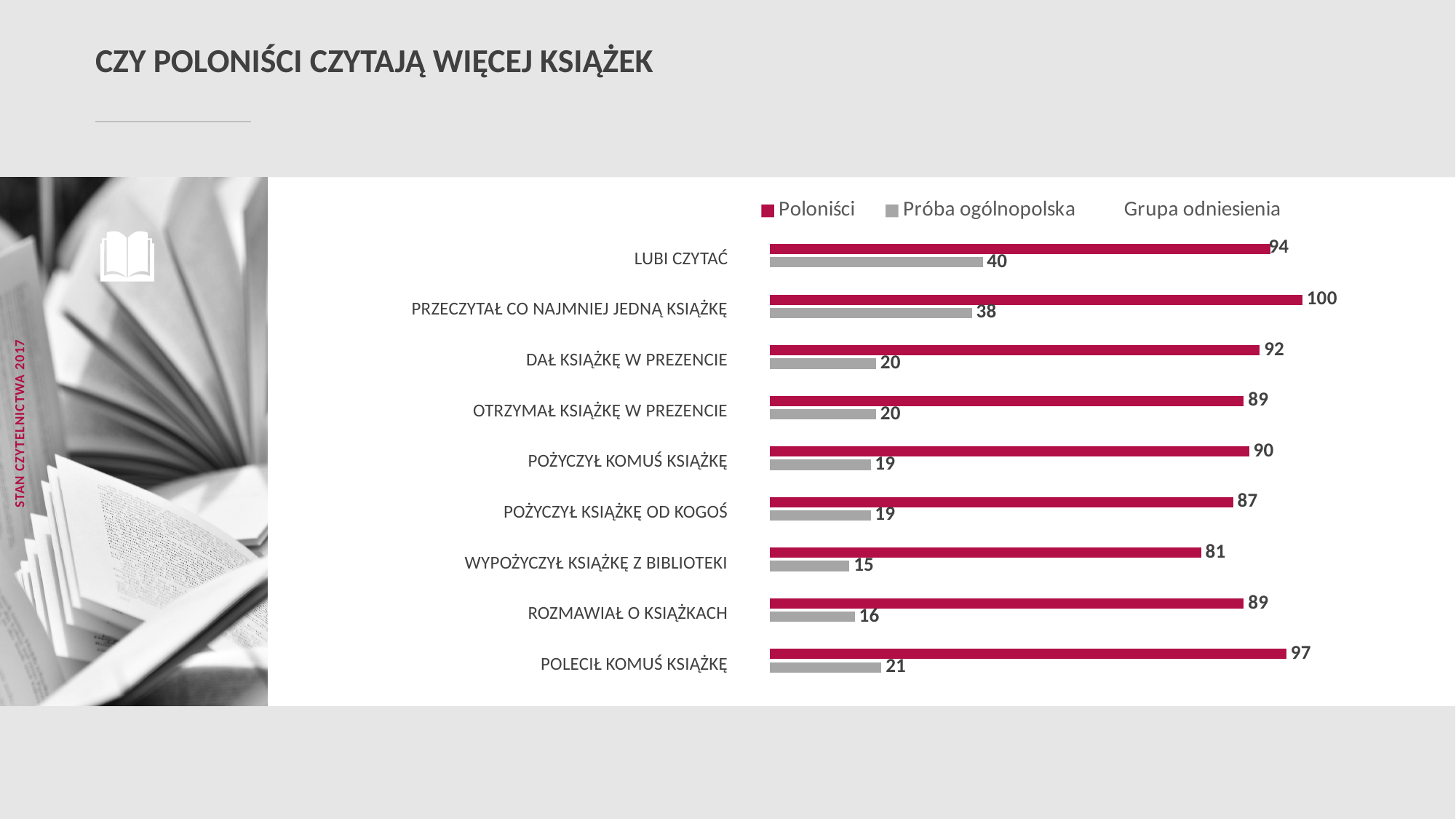
What is the value for Próba ogólnopolska in the category PRZECZYTAŁ CO NAJMNIEJ JEDNĄ KSIĄŻKĘ? 38 What is the value for Poloniści in the category LUBI CZYTAĆ? 94 Which category has the lowest value for Próba ogólnopolska? WYPOŻYCZYŁ KSIĄŻKĘ Z BIBLIOTEKI Which is larger for Próba ogólnopolska: ROZMAWIAŁ O KSIĄŻKACH or POLECIŁ KOMUŚ KSIĄŻKĘ? POLECIŁ KOMUŚ KSIĄŻKĘ Which category has the lowest value for Poloniści? WYPOŻYCZYŁ KSIĄŻKĘ Z BIBLIOTEKI What kind of chart is shown on the slide? Bar chart Which category has the highest value for Poloniści? PRZECZYTAŁ CO NAJMNIEJ JEDNĄ KSIĄŻKĘ Which colour represents the Poloniści series in the chart? Red What is the value for Poloniści in the category WYPOŻYCZYŁ KSIĄŻKĘ Z BIBLIOTEKI? 81 How many categories are shown in the chart? 9 What is the difference between the Poloniści and Próba ogólnopolska values for POLECIŁ KOMUŚ KSIĄŻKĘ? 76 What is the difference between the Próba ogólnopolska values for LUBI CZYTAĆ and DAŁ KSIĄŻKĘ W PREZENCIE? 20